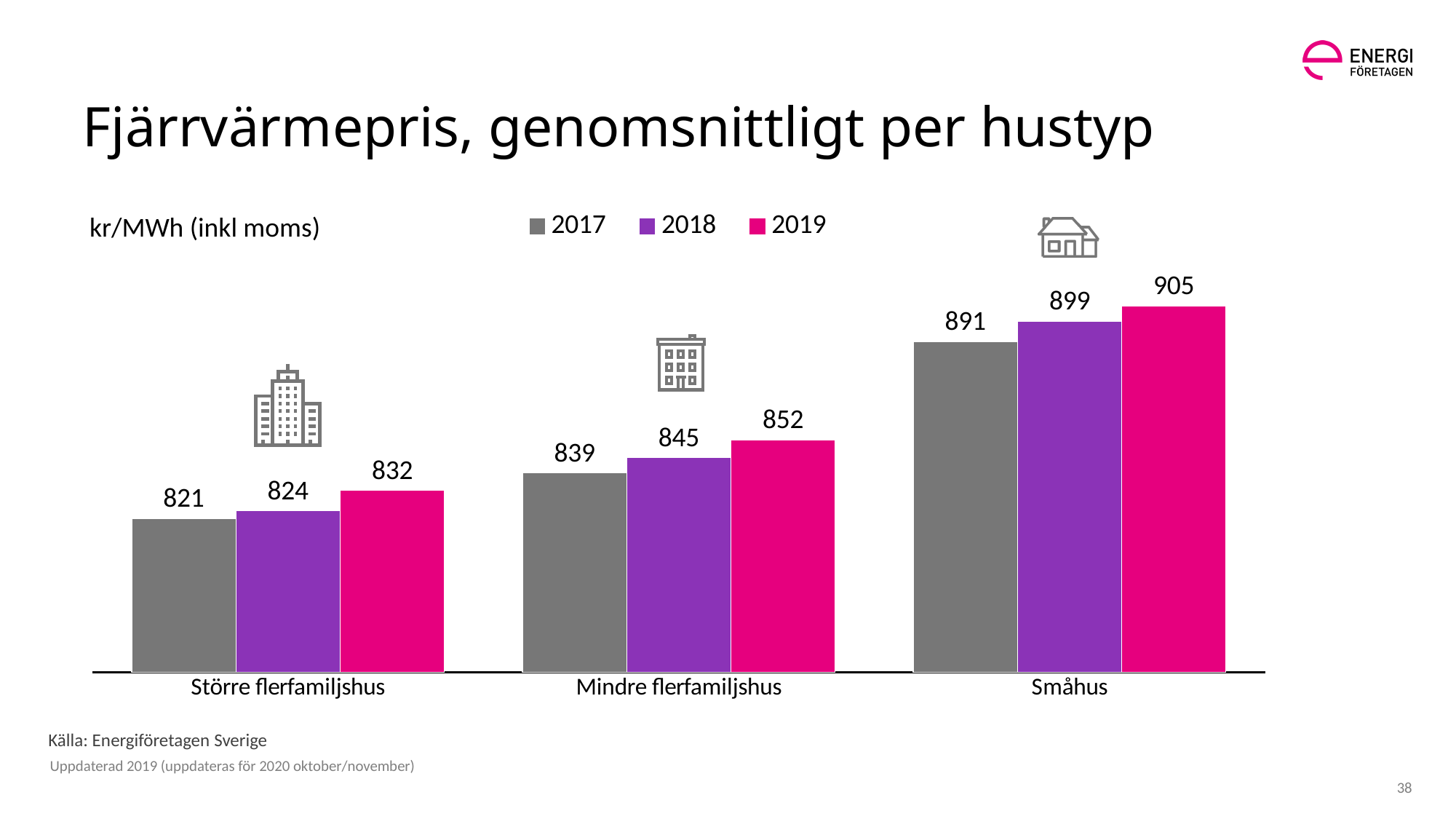
Which house type has the lowest value in 2017? Större flerfamiljshus What is the value for Mindre flerfamiljshus in 2018? 845 Which house type has the highest value in 2019? Småhus What is the difference between the 2019 values for Mindre flerfamiljshus and Större flerfamiljshus? 20 What unit is stated for the values in the chart? kr/MWh (inkl moms) How many house type categories are shown on the x axis? 3 Which is larger: the 2018 value for Mindre flerfamiljshus or the 2019 value for Större flerfamiljshus? 2018 value for Mindre flerfamiljshus How many series does the legend list? 3 What is the value for Småhus in 2019? 905 What is the value for Större flerfamiljshus in 2017? 821 What kind of chart is shown on the slide? Bar chart What is the difference between the 2019 and 2017 values for Småhus? 14